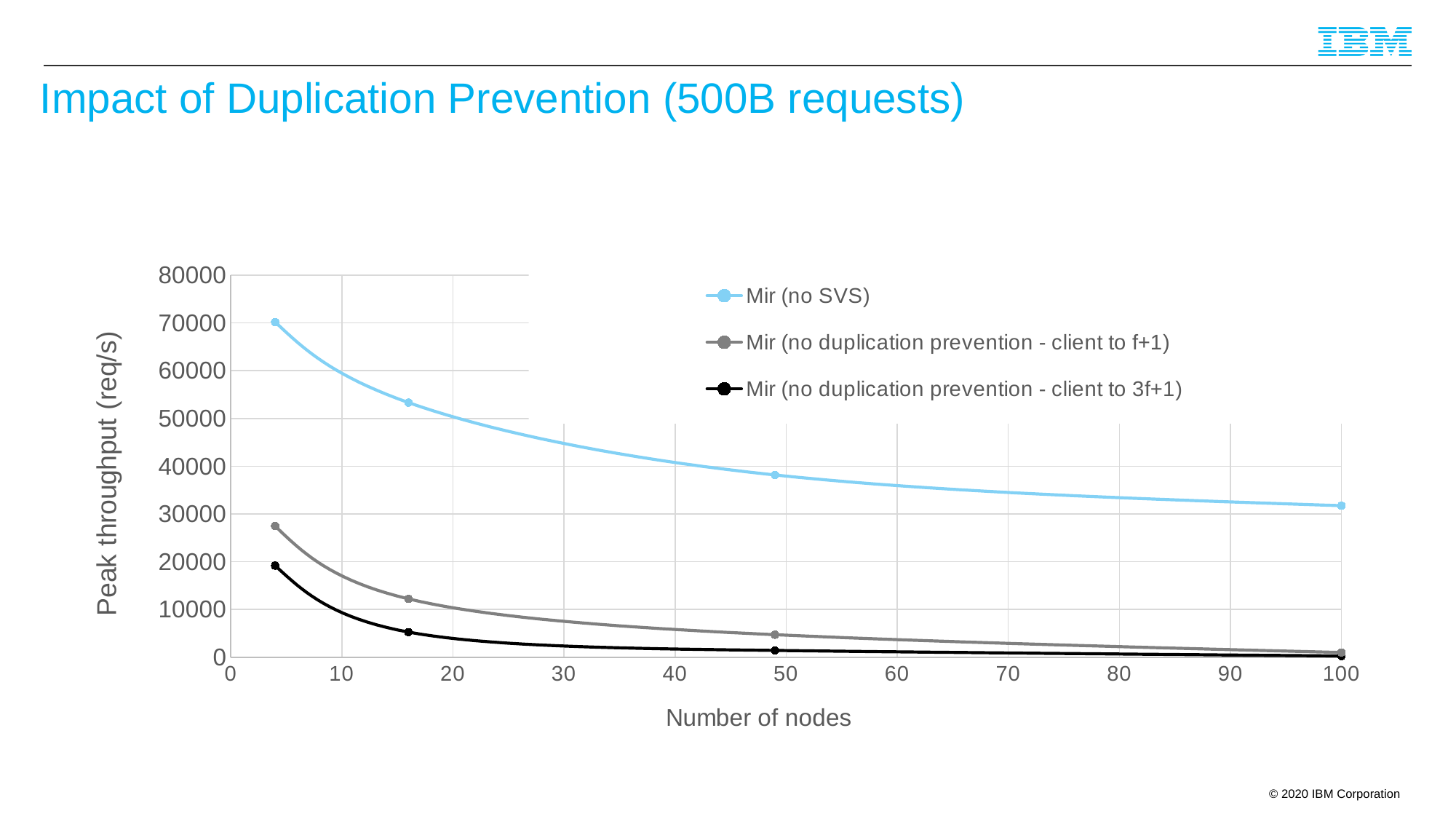
Which series has the highest peak throughput at 100 nodes? Mir (no SVS) Which series has the lowest peak throughput at 4 nodes? Mir (no duplication prevention - client to 3f+1) How many data points are plotted for the Mir (no SVS) series? 4 What is the label of the x axis? Number of nodes Is the peak throughput for Mir (no SVS) at 4 nodes greater or less than 60000? greater Does peak throughput for Mir (no SVS) rise or fall as the number of nodes increases? fall Is the peak throughput for Mir (no duplication prevention - client to 3f+1) at 16 nodes greater or less than 10000? less Is the peak throughput for Mir (no SVS) at 100 nodes greater or less than 40000? less How many series does the legend list? 3 What kind of chart is shown on the slide? line chart At 16 nodes, which has the larger peak throughput: Mir (no SVS) or Mir (no duplication prevention - client to f+1)? Mir (no SVS)